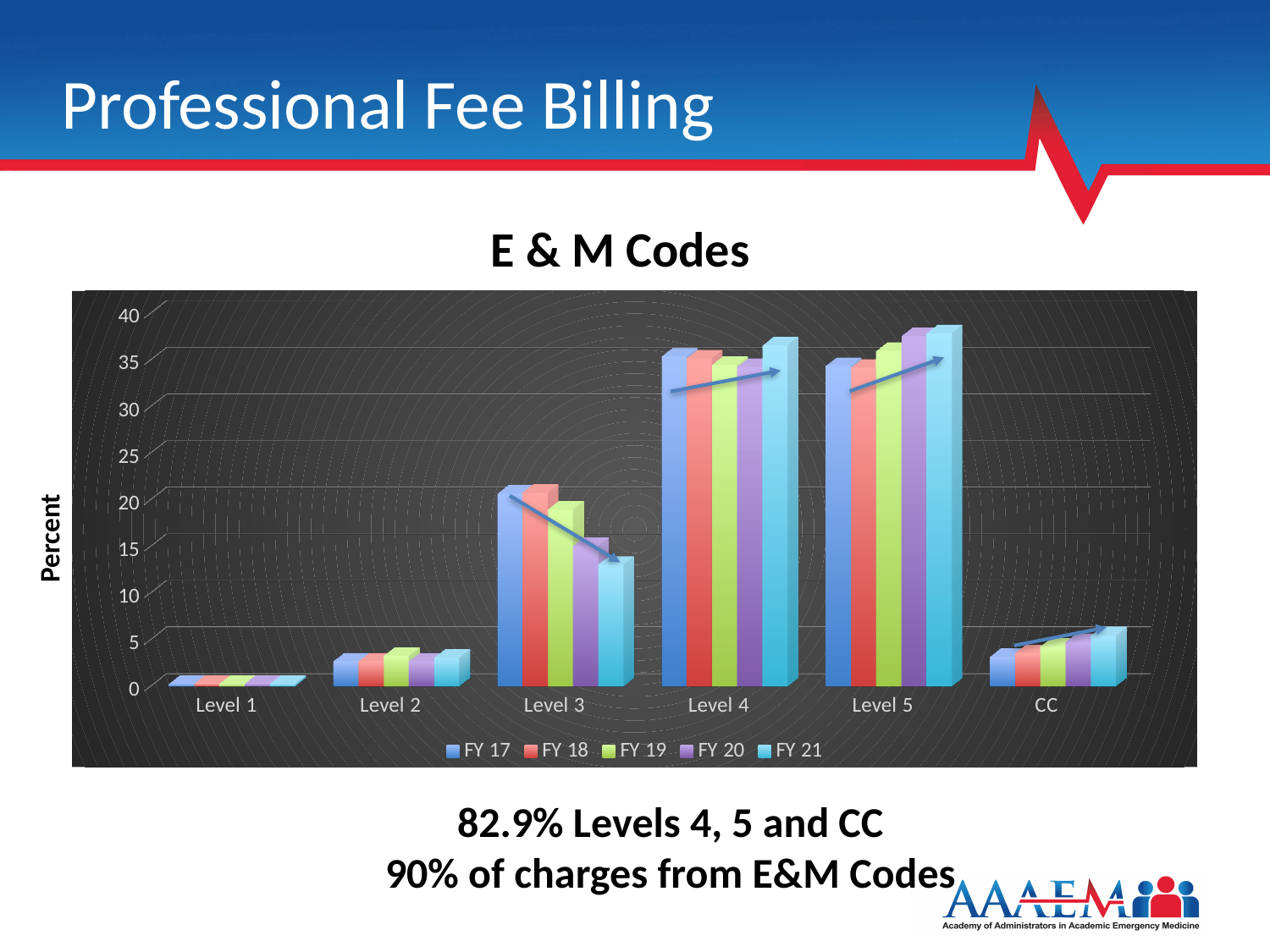
Is the FY 19 value for Level 2 greater or less than 10? less Which category has the lowest values across all fiscal years? Level 1 What is the title of the chart? E & M Codes Is the FY 17 value for Level 3 greater or less than 15? greater Do the values for Level 3 rise or fall from FY 17 to FY 21? fall Is the FY 17 value for Level 5 greater or less than 30? greater How many categories are shown on the x axis? 6 How many series does the legend list? 5 What kind of chart is shown on the slide? bar chart Which is larger, the FY 21 value for Level 4 or the FY 21 value for Level 2? Level 4 What is the label of the vertical axis? Percent